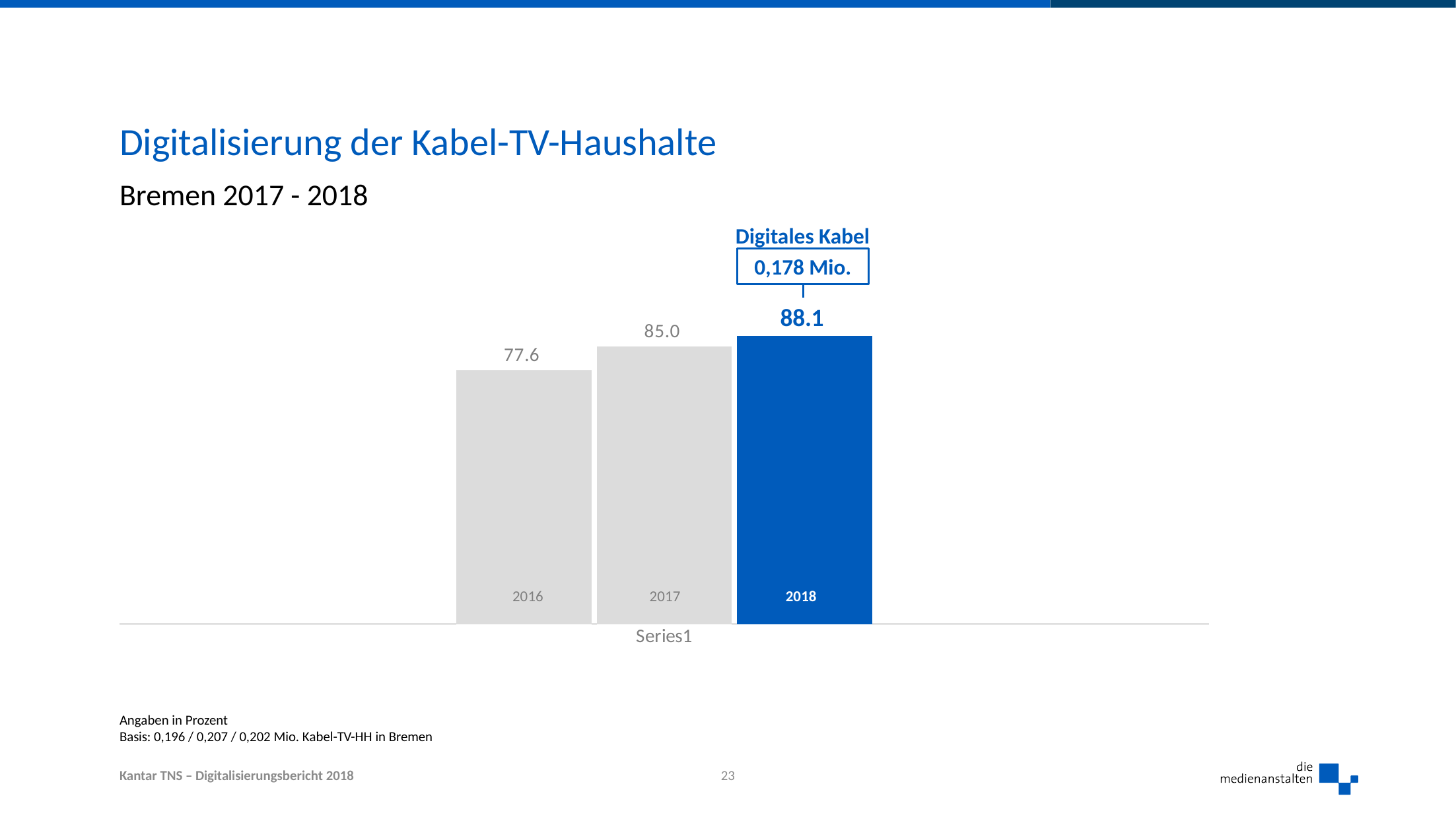
Which year has the lowest value? 2016 What is the value for 2018? 88.1 Which is larger, the value for 2016 or the value for 2017? 2017 What is the difference between the values for 2018 and 2017? 3.1 How many bars are shown in the chart? 3 What kind of chart is shown on the slide? bar chart Do the values rise or fall from 2016 to 2018? rise What is the value for 2017? 85.0 What number of households in millions is shown in the box labelled 'Digitales Kabel' above the 2018 bar? 0,178 Mio. Which year has the highest value? 2018 What is the difference between the values for 2017 and 2016? 7.4 What is the value for 2016? 77.6